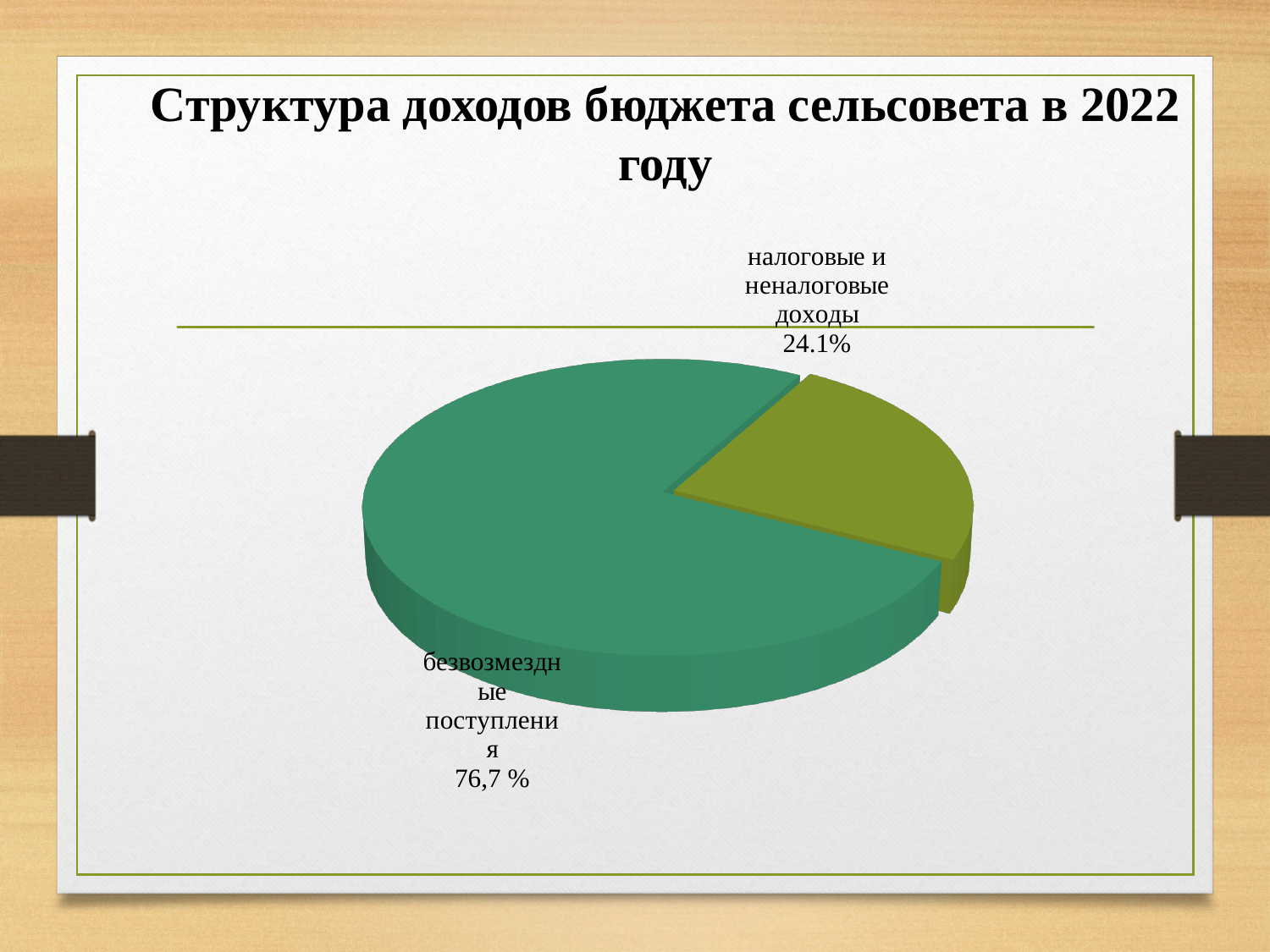
What share of the pie is labelled for "безвозмездные поступления"? 76,7 % Which slice of the pie is the largest? безвозмездные поступления Which is larger: the share for "безвозмездные поступления" or the share for "налоговые и неналоговые доходы"? безвозмездные поступления How many slices does the pie chart have? 2 What share of the pie is labelled for "налоговые и неналоговые доходы"? 24.1% What is the title of the chart on the slide? Структура доходов бюджета сельсовета в 2022 году Is the share for "безвозмездные поступления" greater or less than 50%? greater What kind of chart is shown on the slide? pie chart What colour is the slice for "налоговые и неналоговые доходы"? olive green Which slice of the pie is the smallest? налоговые и неналоговые доходы Is the share for "налоговые и неналоговые доходы" greater or less than 50%? less